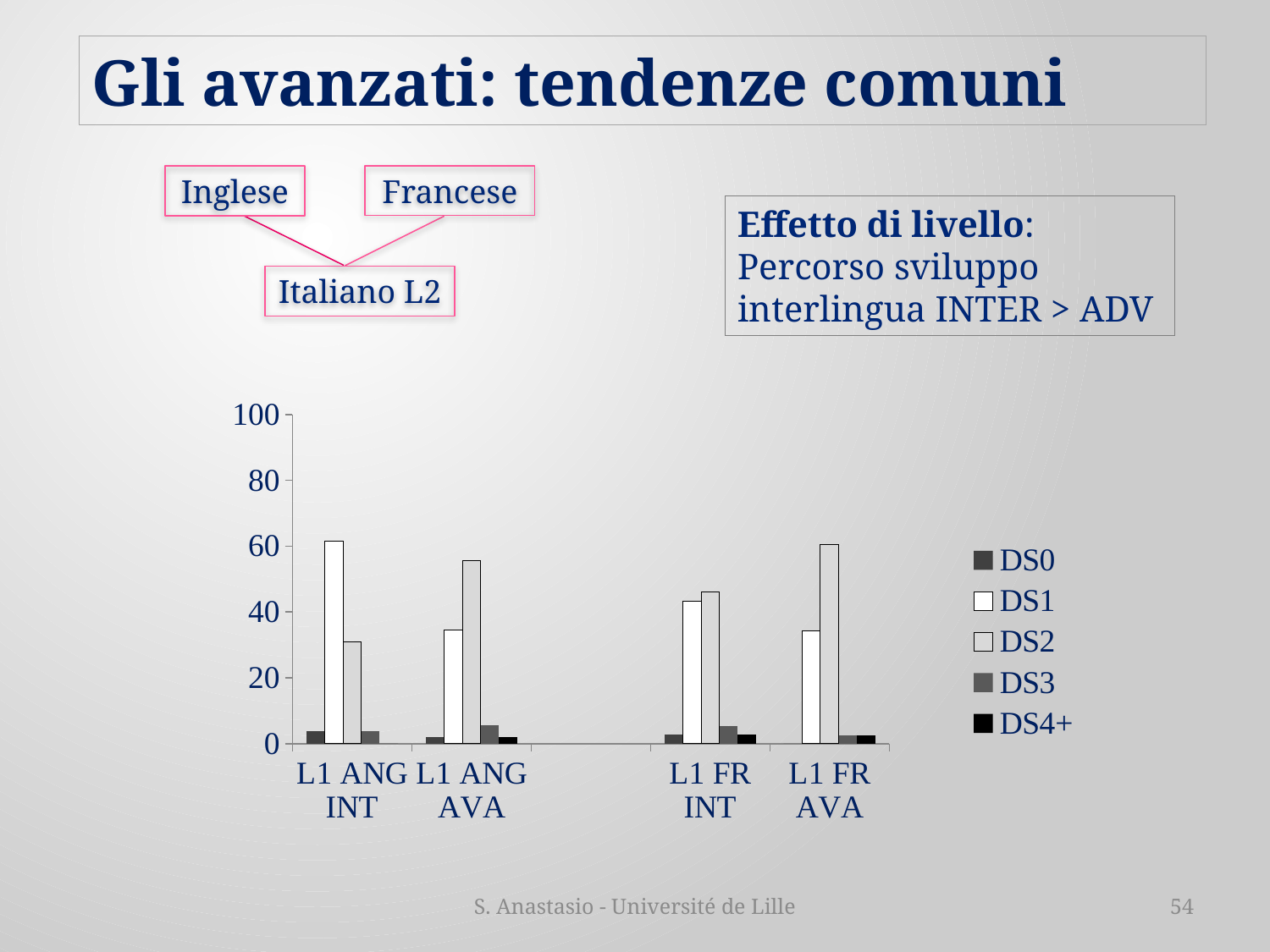
In the L1 ANG INT group, which is larger, DS1 or DS2? DS1 Is the DS2 value for L1 ANG INT greater or less than 40? less In the L1 ANG AVA group, which is larger, DS1 or DS2? DS2 How many series does the chart legend list? 5 Which series has the tallest bar in the L1 FR AVA group? DS2 What kind of chart is shown on the slide? bar chart Which legend entry is shown with a black marker? DS4+ How many labelled categories appear on the x axis of the chart? 4 Is the DS1 value for L1 ANG INT greater or less than 40? greater What is the highest value shown on the chart's vertical axis? 100 Is the DS2 value for L1 FR AVA greater or less than 40? greater Which series has the tallest bar in the L1 ANG INT group? DS1